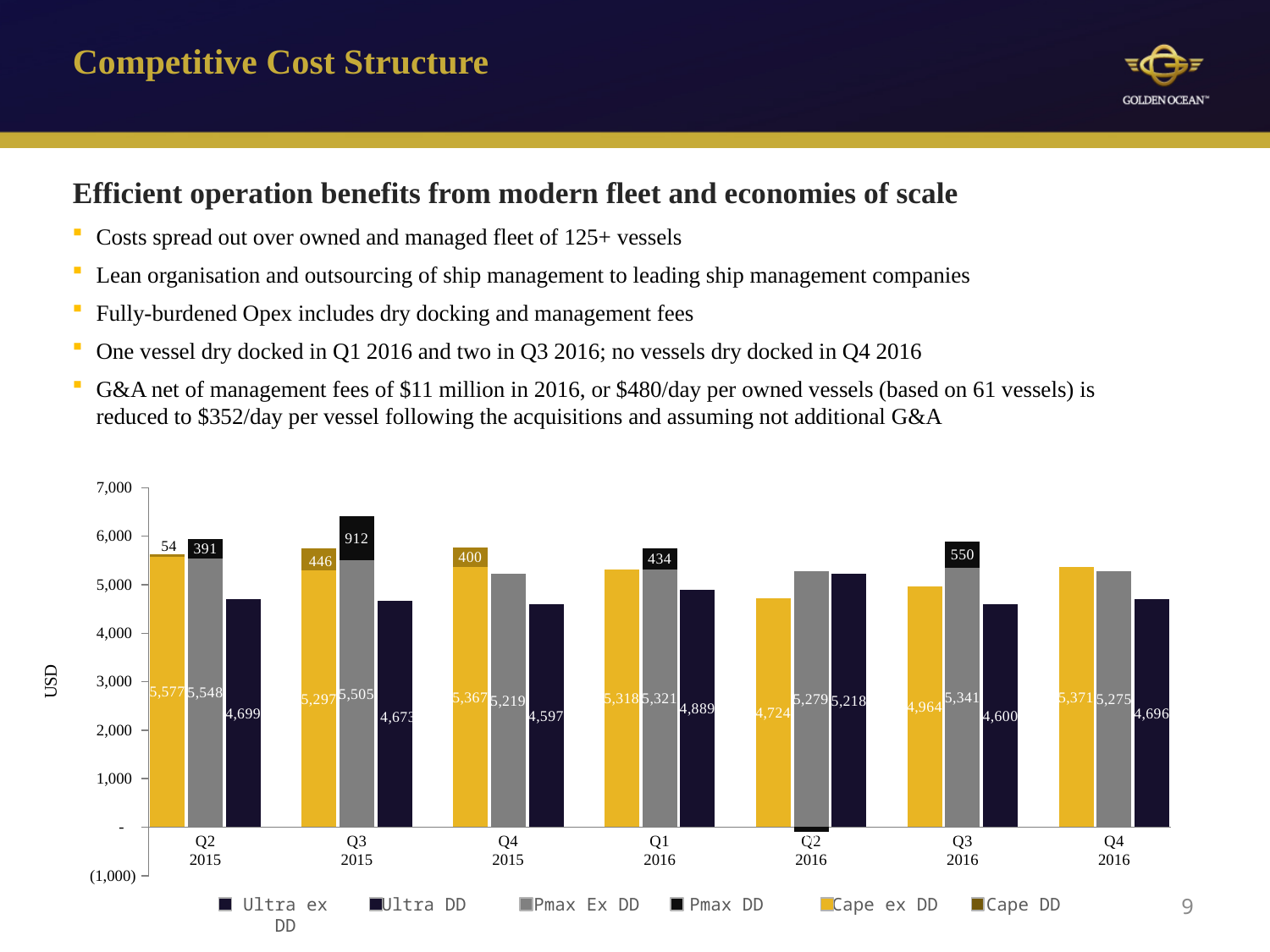
How many series does the chart legend list? 6 What is the Cape DD value for Q4 2015? 400 What kind of chart is shown on the slide? Bar chart In which quarter is the Pmax DD value highest? Q3 2015 What is the difference between the Cape ex DD value in Q4 2016 and in Q2 2016? 647 What label is shown on the vertical axis of the chart? USD What is the Ultra ex DD value for Q1 2016? 4,889 What is the Pmax DD value for Q3 2015? 912 What is the total of the stacked Pmax bar (Pmax Ex DD plus Pmax DD) for Q3 2015? 6,417 How many quarters are shown along the x axis of the chart? 7 In Q2 2016, which is larger: the Ultra ex DD value or the Cape ex DD value? Ultra ex DD What is the Cape ex DD value for Q2 2015? 5,577